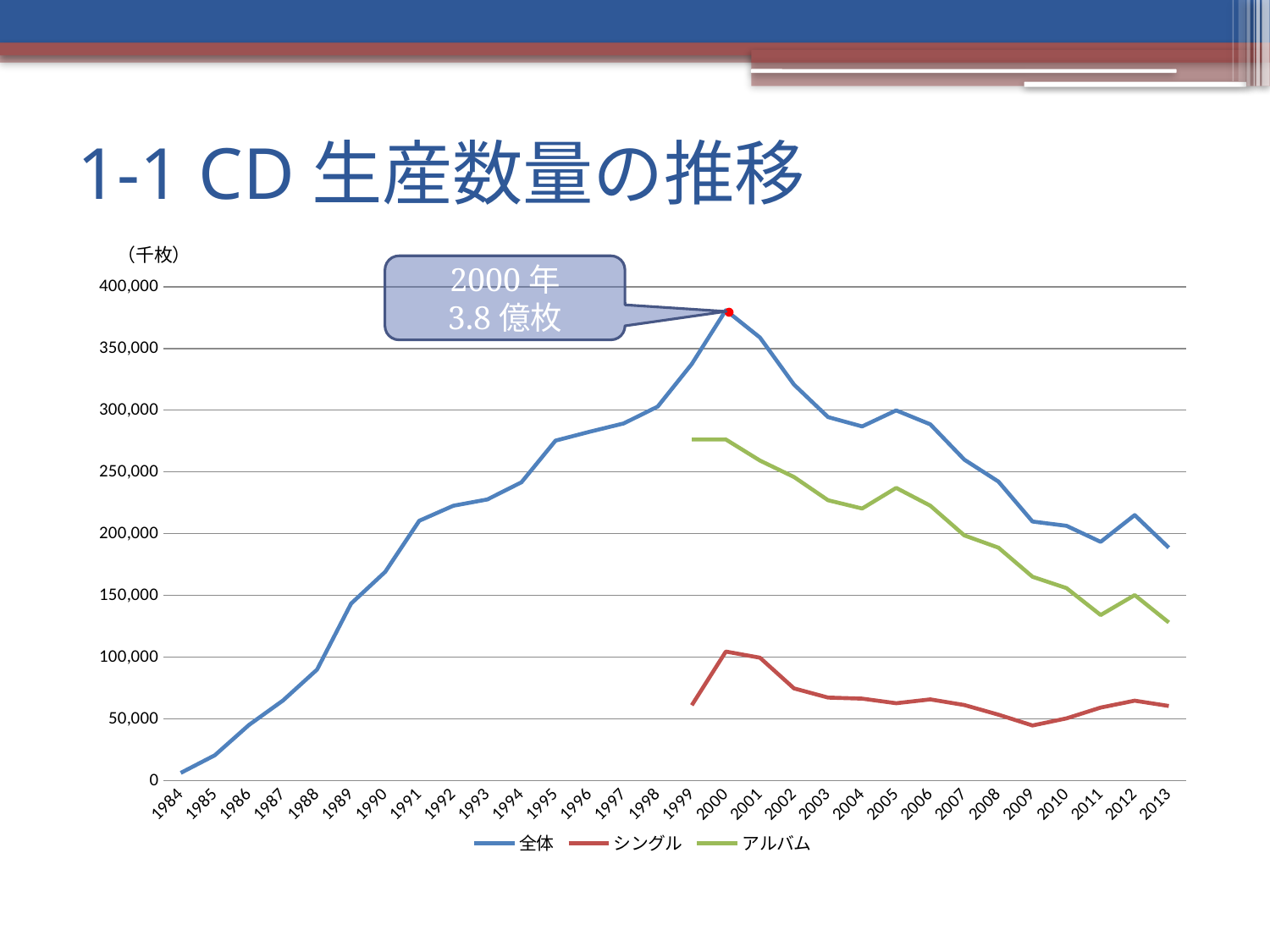
Is the value for 全体 in 2005 greater or less than 250,000? greater What kind of chart is shown on the slide? line chart Is the value for 全体 in 1984 greater or less than 50,000? less In which year does the 全体 series reach its highest value? 2000 In which year is the 全体 series at its lowest value? 1984 Does the 全体 series rise or fall from 2000 to 2013? fall What unit is shown at the top of the y axis? 千枚 How many series does the legend list? 3 Which series has the larger value in 2005, アルバム or シングル? アルバム Is the value for アルバム in 2013 greater or less than 150,000? less How many years are shown along the x axis? 30 According to the callout, what was the total CD production in 2000? 3.8 億枚